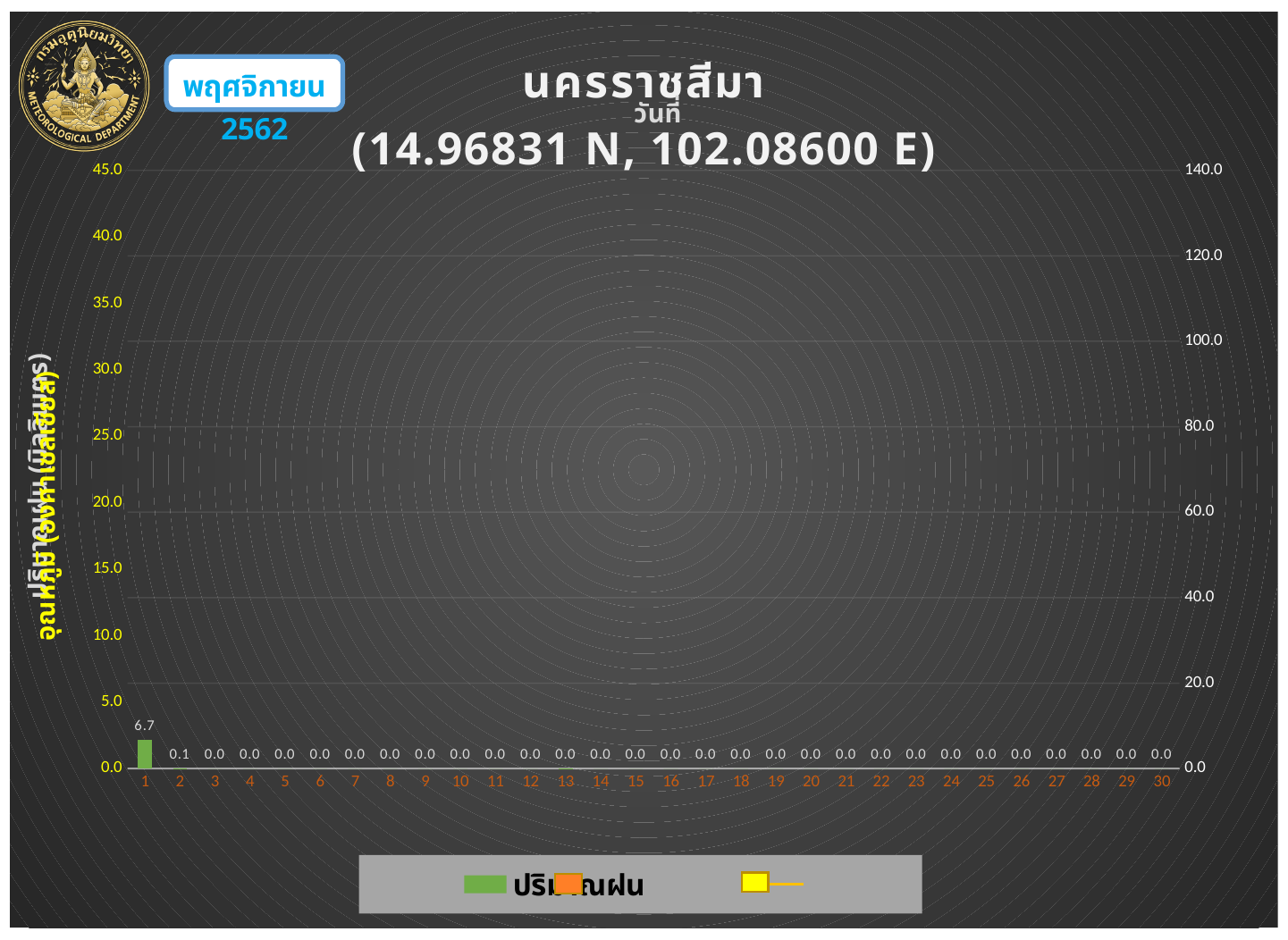
Which day has the highest rainfall value? 1 How many days are shown on the x axis? 30 Is the rainfall value for day 1 greater or less than 10.0? less What kind of chart is used to show the rainfall values? bar chart What is the highest tick value on the right vertical axis? 140.0 What is the rainfall value shown for day 1? 6.7 What is the difference between the rainfall values for day 1 and day 2? 6.6 What is the rainfall value shown for day 15? 0.0 What is the total rainfall for days 1 and 2 combined? 6.8 What is the highest tick value on the left vertical axis? 45.0 What is the rainfall value shown for day 2? 0.1 Which has a larger rainfall value, day 1 or day 2? day 1